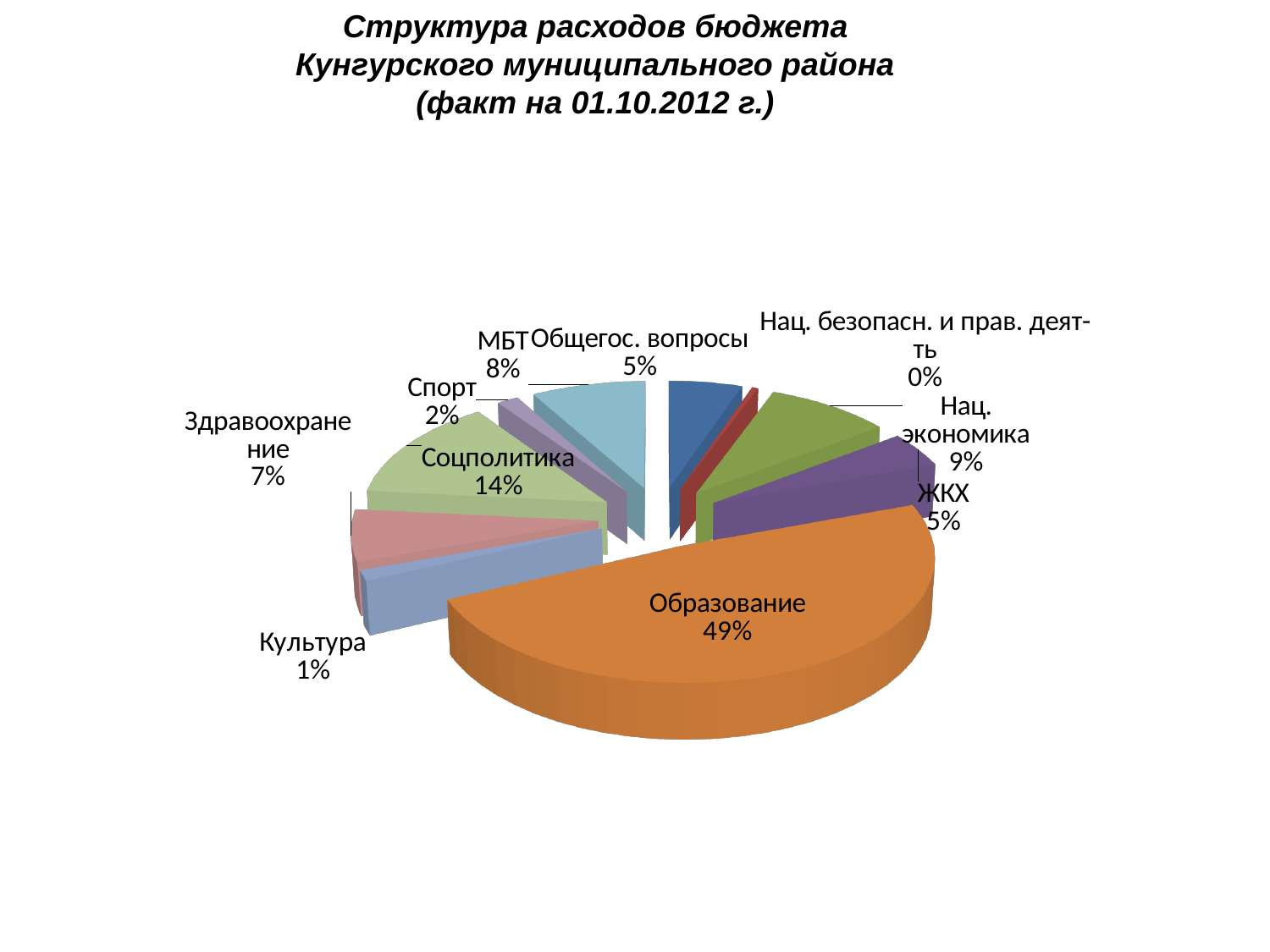
How many categories are shown in the pie chart? 10 Which category has the smallest share, shown as 0%? Нац. безопасн. и прав. деят-ть What is the value shown for МБТ? 8% What kind of chart is shown on the slide? Pie chart What share of the pie does Образование have? 49% Which is larger, the share for Нац. экономика or the share for ЖКХ? Нац. экономика What date is given in the chart title for the actual figures? 01.10.2012 г. What share of the pie does Соцполитика have? 14% Which category has the largest slice of the pie? Образование What is the value shown for Здравоохранение? 7% What is the value shown for Нац. экономика? 9% What is the difference in percentage points between Образование and Соцполитика? 35